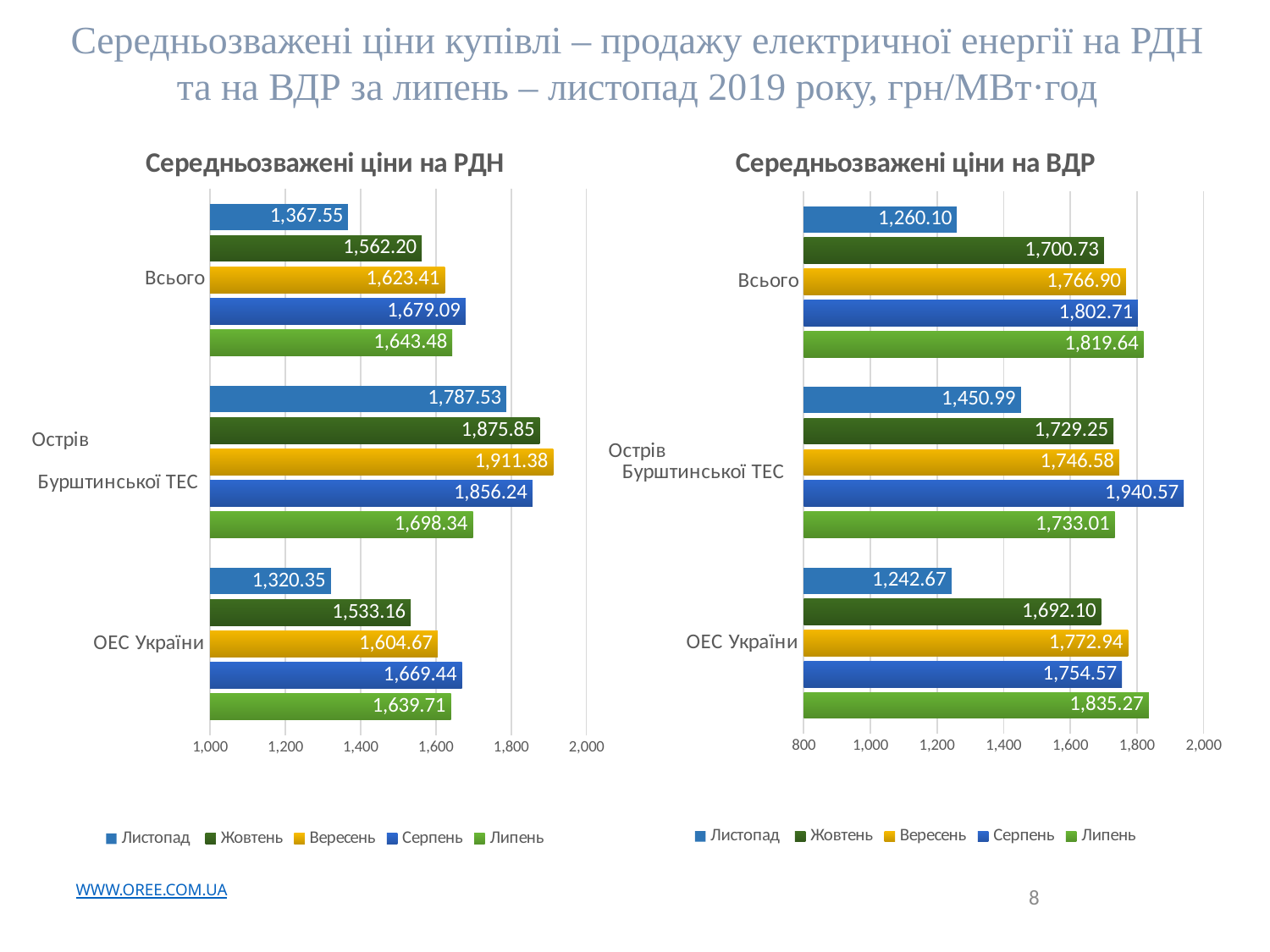
In the chart 'Середньозважені ціни на ВДР', what is the difference between the Липень and Листопад values for ОЕС України? 592.60 In the chart 'Середньозважені ціни на ВДР', which month has the lowest value for Всього? Листопад What kind of chart is 'Середньозважені ціни на РДН'? Bar chart In the chart 'Середньозважені ціни на ВДР', which is larger for Всього: the Серпень value or the Жовтень value? Серпень In the chart 'Середньозважені ціни на РДН', what is the difference between the Вересень and Листопад values for Острів Бурштинської ТЕС? 123.85 How many series does the legend of the chart 'Середньозважені ціни на РДН' list? 5 In the chart 'Середньозважені ціни на РДН', which month has the highest value for Острів Бурштинської ТЕС? Вересень In the chart 'Середньозважені ціни на РДН', what is the value for Всього in Листопад? 1,367.55 In the chart 'Середньозважені ціни на ВДР', what is the value for Острів Бурштинської ТЕС in Серпень? 1,940.57 In the chart 'Середньозважені ціни на РДН', what is the value for ОЕС України in Вересень? 1,604.67 How many categories are shown on the y axis of the chart 'Середньозважені ціни на ВДР'? 3 In the chart 'Середньозважені ціни на ВДР', what is the value for ОЕС України in Липень? 1,835.27